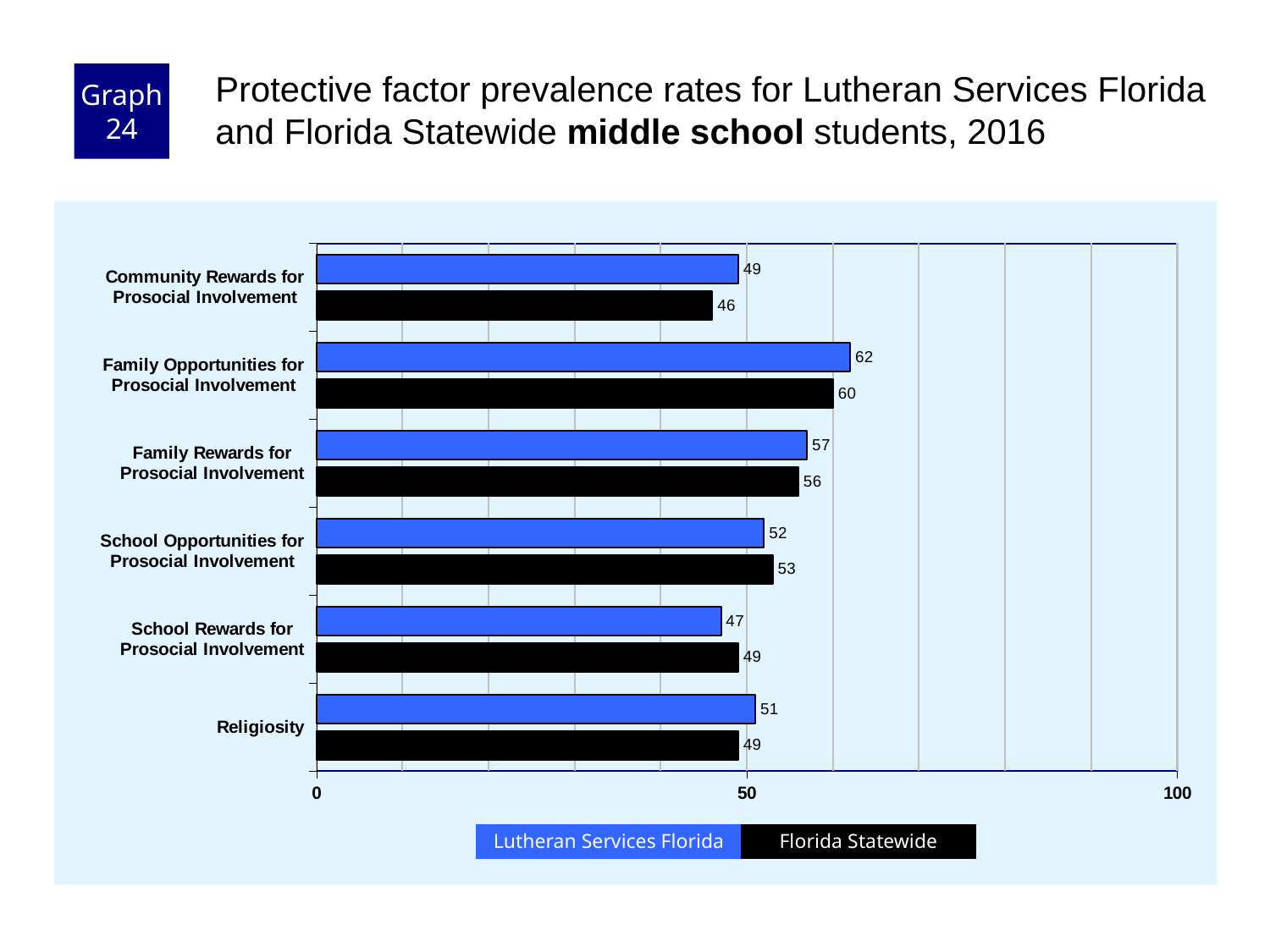
How many series does the legend list? 2 How many categories are shown on the chart? 6 What is the difference between the Lutheran Services Florida and Florida Statewide values for Community Rewards for Prosocial Involvement? 3 Is the Lutheran Services Florida value for Family Rewards for Prosocial Involvement greater or less than 50? greater Which colour represents Florida Statewide in the chart? black Which category has the highest Lutheran Services Florida value? Family Opportunities for Prosocial Involvement What is the Florida Statewide value for Community Rewards for Prosocial Involvement? 46 Which category has the lowest Florida Statewide value? Community Rewards for Prosocial Involvement What is the Lutheran Services Florida value for Family Opportunities for Prosocial Involvement? 62 What kind of chart is shown on the slide? bar chart What is the Florida Statewide value for Religiosity? 49 For School Rewards for Prosocial Involvement, which is larger: the Lutheran Services Florida value or the Florida Statewide value? Florida Statewide